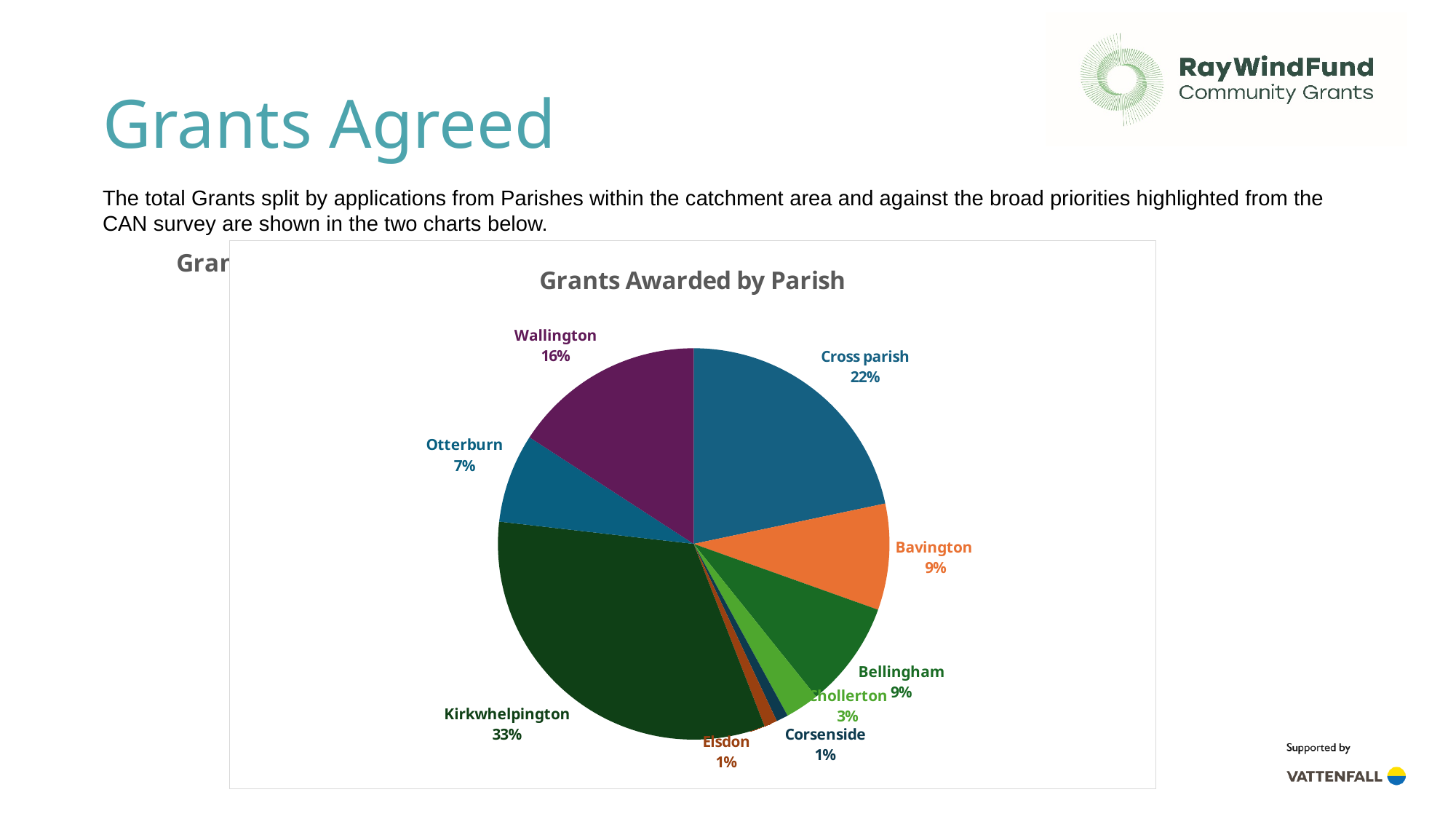
What is the title of the chart? Grants Awarded by Parish What share of grants was awarded to Otterburn? 7% How many parishes are shown in the pie chart? 9 What share of grants was awarded to Wallington? 16% Which parish received the largest share of grants? Kirkwhelpington What is the difference in percentage points between Kirkwhelpington's share and Cross parish's share? 11 What share of grants was awarded to Bellingham? 9% What type of chart is shown on the slide? pie chart Which received a larger share of grants, Wallington or Bavington? Wallington